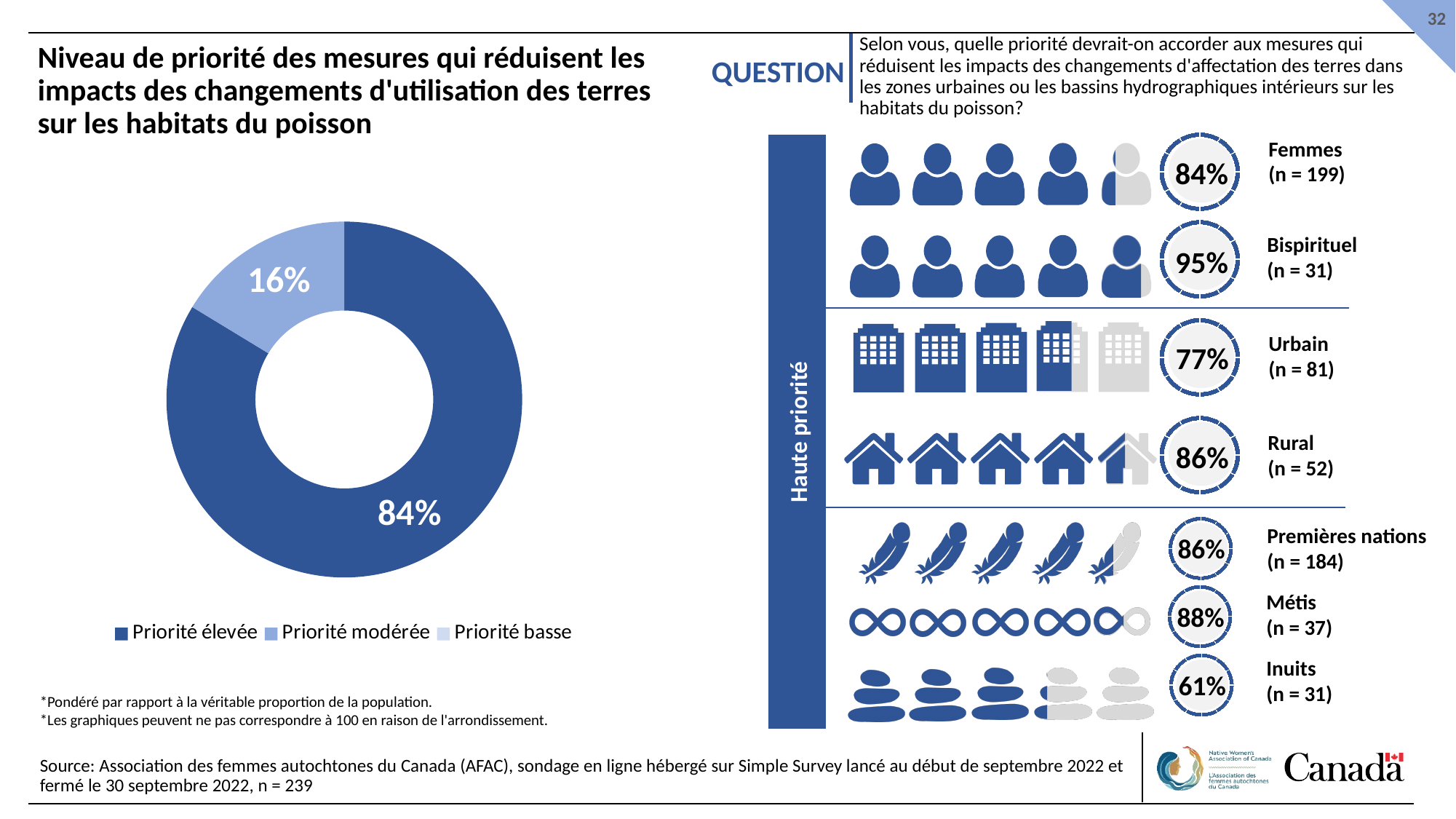
In the donut chart on the left, which category has the largest share? Priorité élevée In the 'Haute priorité' infographic on the right, which has the higher percentage, 'Urbain' or 'Rural'? Rural In the 'Haute priorité' infographic on the right, what percentage is shown for 'Inuits'? 61% In the 'Haute priorité' infographic on the right, which group has the lowest percentage? Inuits What kind of chart is shown on the left side of the slide? Donut (pie) chart In the donut chart on the left, what is the difference in percentage points between 'Priorité élevée' and 'Priorité modérée'? 68 percentage points In the donut chart on the left, what percentage is shown for 'Priorité modérée'? 16% In the 'Haute priorité' infographic on the right, which group has the highest percentage? Bispirituel In the donut chart on the left, what percentage is shown for 'Priorité élevée'? 84% In the 'Haute priorité' infographic on the right, what percentage is shown for 'Bispirituel'? 95% In the 'Haute priorité' infographic on the right, what is the sample size (n) shown for 'Femmes'? n = 199 How many entries does the legend of the donut chart on the left list? 3